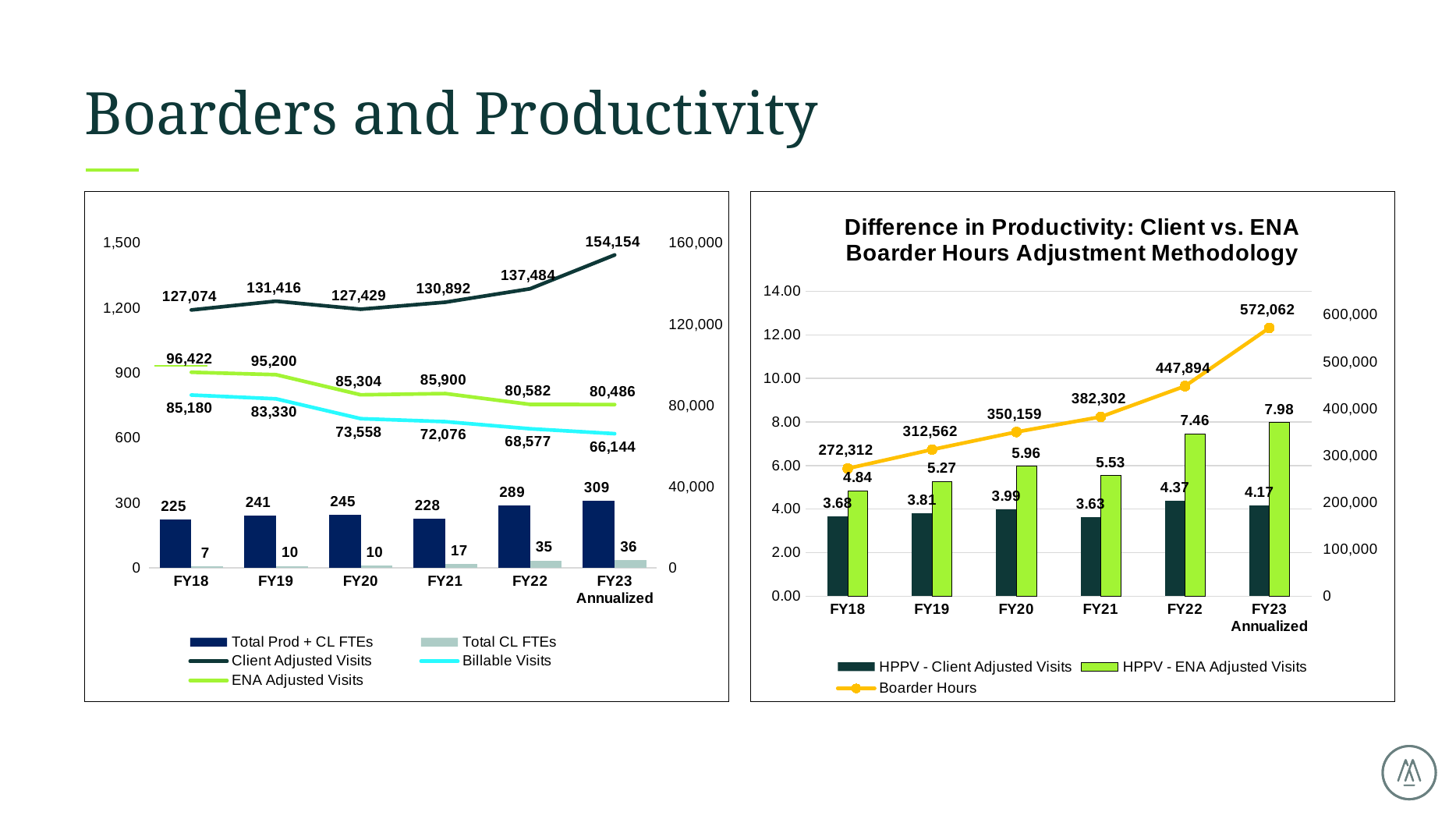
In the chart titled 'Difference in Productivity: Client vs. ENA Boarder Hours Adjustment Methodology', which fiscal year has the highest HPPV - ENA Adjusted Visits? FY23 Annualized In the chart titled 'Difference in Productivity: Client vs. ENA Boarder Hours Adjustment Methodology', what is the difference between HPPV - ENA Adjusted Visits and HPPV - Client Adjusted Visits in FY22? 3.09 In the chart titled 'Difference in Productivity: Client vs. ENA Boarder Hours Adjustment Methodology', what colour is the Boarder Hours line? Orange/yellow In the left chart, what is the Client Adjusted Visits value for FY23 Annualized? 154,154 In the left chart, what is the value of Total Prod + CL FTEs for FY22? 289 In the left chart, do ENA Adjusted Visits generally rise or fall from FY18 to FY23 Annualized? fall In the chart titled 'Difference in Productivity: Client vs. ENA Boarder Hours Adjustment Methodology', what is the Boarder Hours value for FY20? 350,159 In the left chart, which fiscal year has the lowest Billable Visits? FY23 Annualized In the left chart, what is the difference between Total CL FTEs in FY22 and FY21? 18 How many series does the legend of the left chart list? 5 In the chart titled 'Difference in Productivity: Client vs. ENA Boarder Hours Adjustment Methodology', which is larger in FY21: HPPV - Client Adjusted Visits or HPPV - ENA Adjusted Visits? HPPV - ENA Adjusted Visits In the chart titled 'Difference in Productivity: Client vs. ENA Boarder Hours Adjustment Methodology', how many fiscal year categories are shown on the x axis? 6